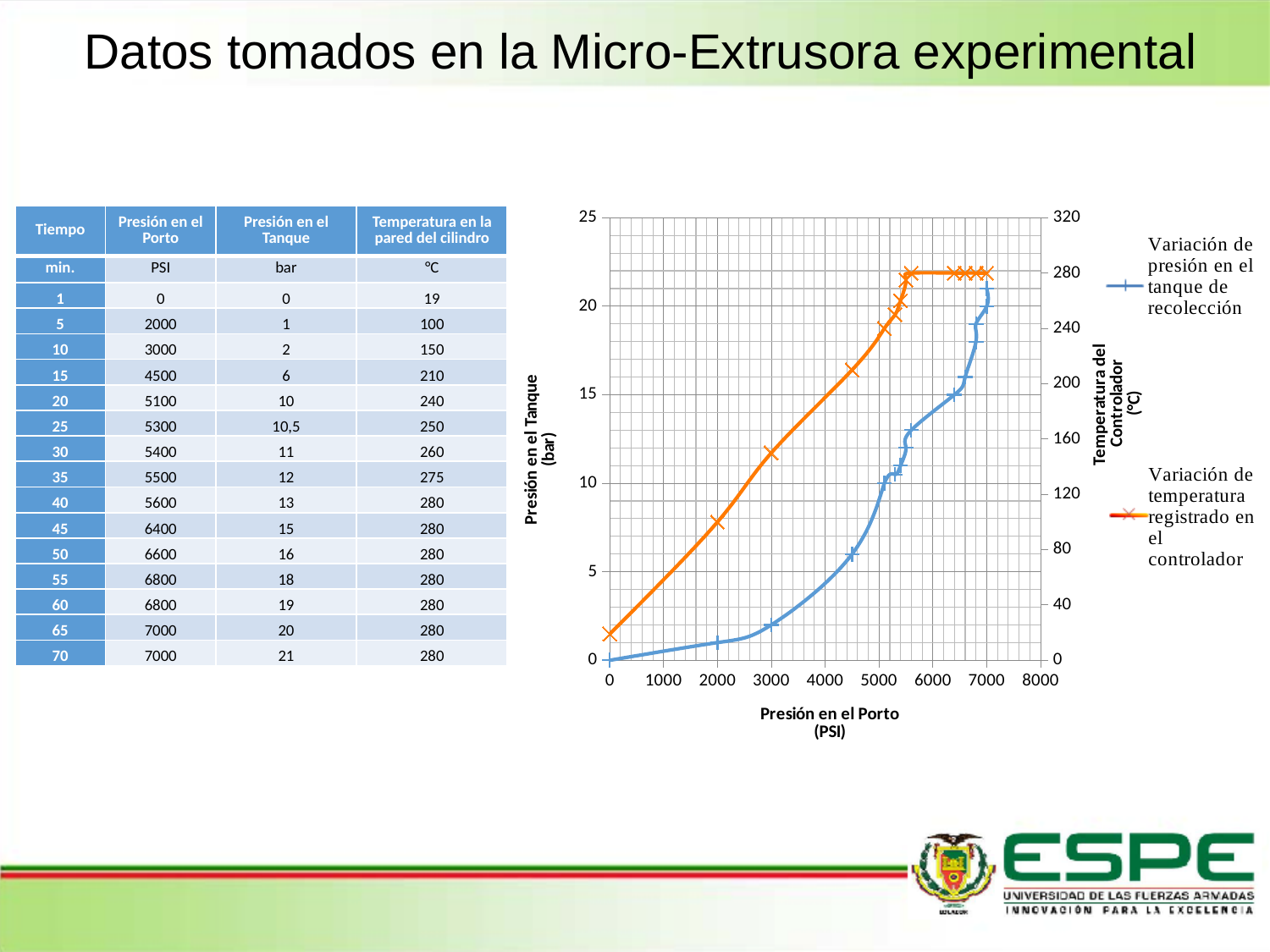
What is the highest temperature value the temperature series reaches on the chart? 280 What kind of chart is shown on the slide? line chart How many series does the chart's legend list? 2 Does the tank pressure series rise or fall as Presión en el Porto increases? rises What is the highest value shown on the chart's x axis? 8000 Does the temperature series rise or fall as Presión en el Porto increases from 0 to 5000 PSI? rises Is the controller temperature at 2000 PSI greater or less than 80 °C? greater Is the tank pressure at 7000 PSI greater or less than 15 bar? greater Is the tank pressure at 3000 PSI greater or less than 5 bar? less What is the title of the chart's x axis? Presión en el Porto (PSI) What is the title of the chart's right-hand y axis? Temperatura del Controlador (°C)